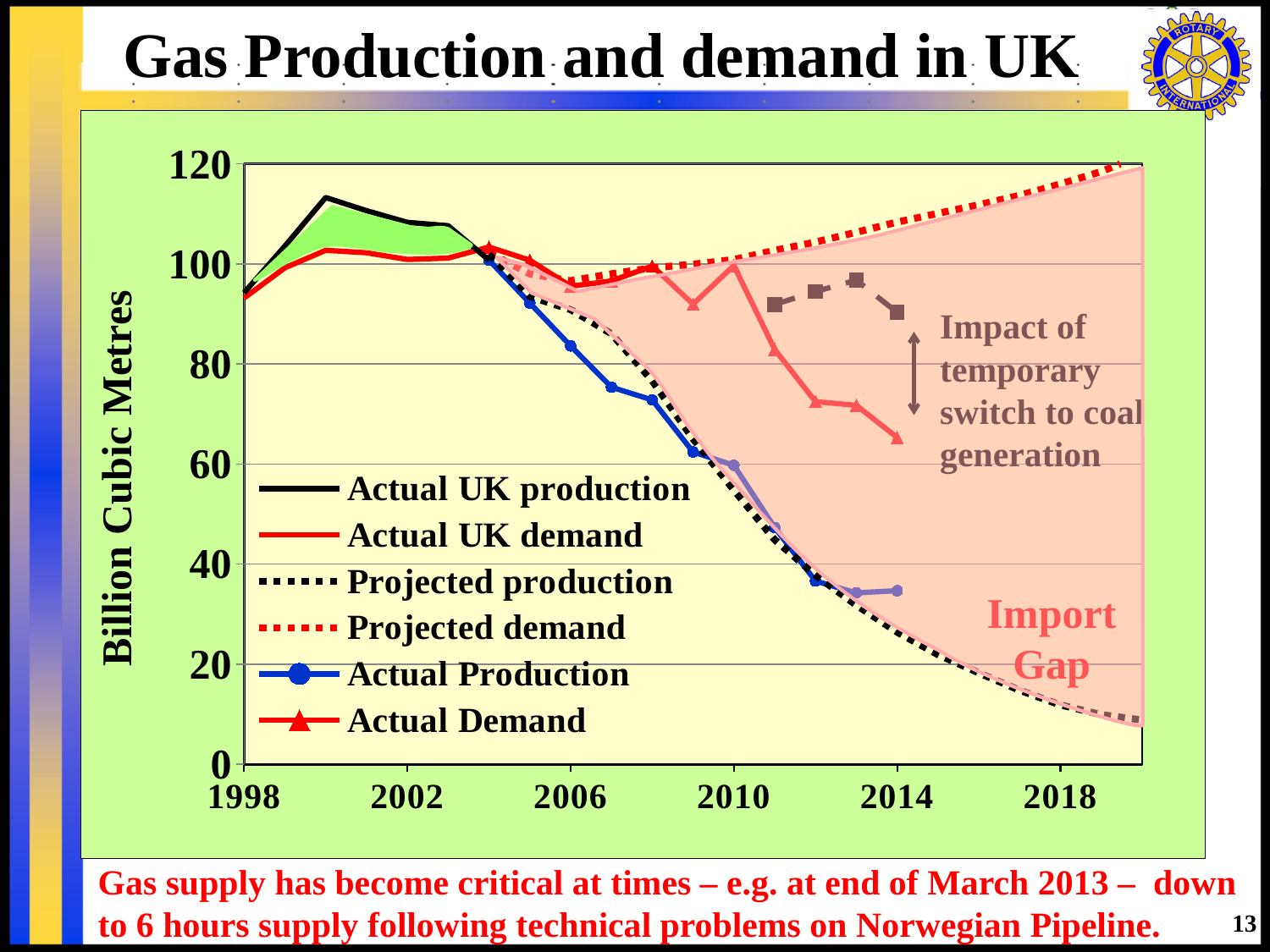
Is the value for Actual UK production in 2000 greater or less than 100? greater Does the Projected demand series rise or fall from 2006 to 2018? rise Is the value for Projected demand in 2018 greater or less than 100? greater What is the title of the chart? Gas Production and demand in UK Is the value for Projected production in 2018 greater or less than 20? less How many series does the legend list? 6 What is the label on the vertical axis? Billion Cubic Metres In 2014, which is larger: Actual Demand or Actual Production? Actual Demand Does the Actual Production series rise or fall between 2004 and 2014? fall What kind of chart is shown on the slide? line chart